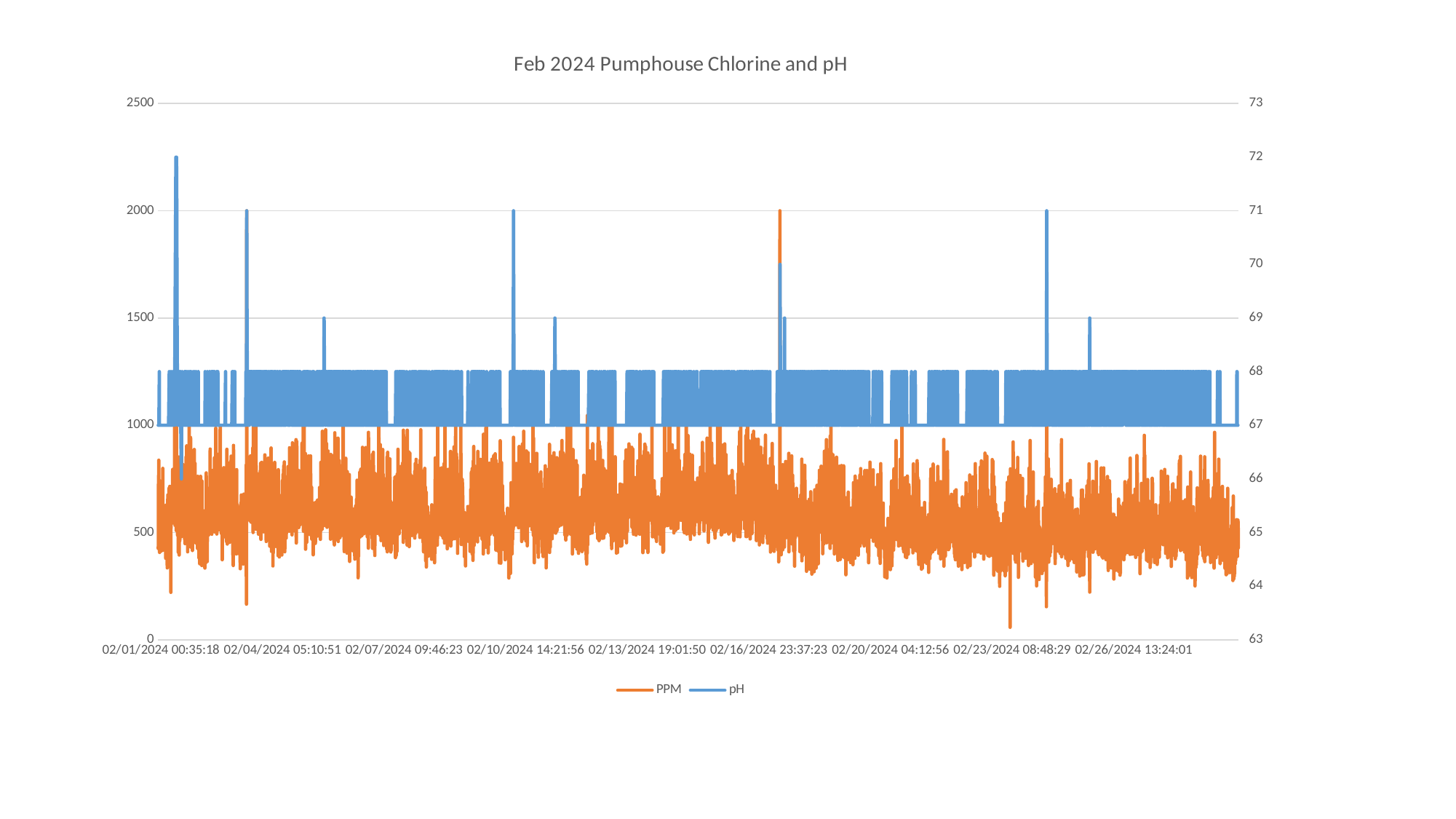
Which series is drawn in orange according to the legend? PPM Measured on the left-hand axis, is the lowest dip of the orange PPM line greater or less than 500? less What is the title of the chart? Feb 2024 Pumphouse Chlorine and pH How many date labels are printed along the x axis? 9 What is the last date label on the x axis? 02/26/2024 13:24:01 What is the highest value shown on the left-hand vertical axis? 2500 What is the lowest value shown on the right-hand vertical axis? 63 What is the first date label on the x axis? 02/01/2024 00:35:18 What kind of chart is shown on the slide? line chart How many series does the legend list? 2